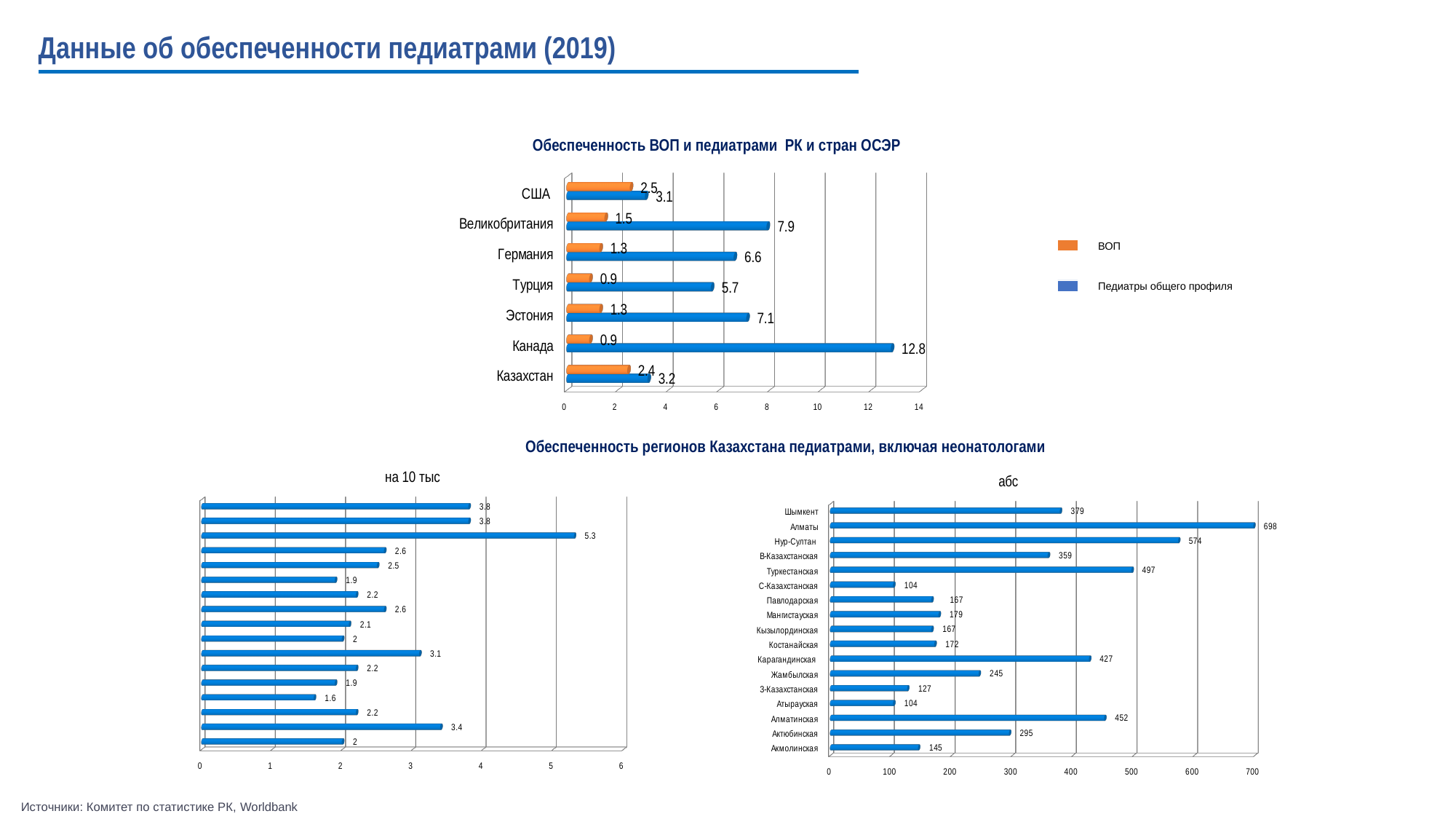
In the bottom-right chart 'абс', which region has the highest value? Алматы How many series does the legend of the chart 'Обеспеченность ВОП и педиатрами РК и стран ОСЭР' list? 2 In the chart 'Обеспеченность ВОП и педиатрами РК и стран ОСЭР', what is the value for Педиатры общего профиля in Канада? 12.8 How many countries are shown in the chart 'Обеспеченность ВОП и педиатрами РК и стран ОСЭР'? 7 In the chart 'Обеспеченность ВОП и педиатрами РК и стран ОСЭР', what is the difference between the Педиатры общего профиля and ВОП values for Великобритания? 6.4 In the chart 'Обеспеченность ВОП и педиатрами РК и стран ОСЭР', which has the larger Педиатры общего профиля value, Германия or Эстония? Эстония In the bottom-right chart 'абс', what is the difference between the values for Нур-Султан and Шымкент? 195 In the chart 'Обеспеченность ВОП и педиатрами РК и стран ОСЭР', what is the ВОП value for Казахстан? 2.4 In the bottom-right chart 'абс', is the value for Карагандинская greater or less than 400? greater What kind of chart is the bottom-left chart 'на 10 тыс'? bar chart In the chart 'Обеспеченность ВОП и педиатрами РК и стран ОСЭР', which country has the highest value for Педиатры общего профиля? Канада In the bottom-right chart 'абс', what is the value for Алматы? 698